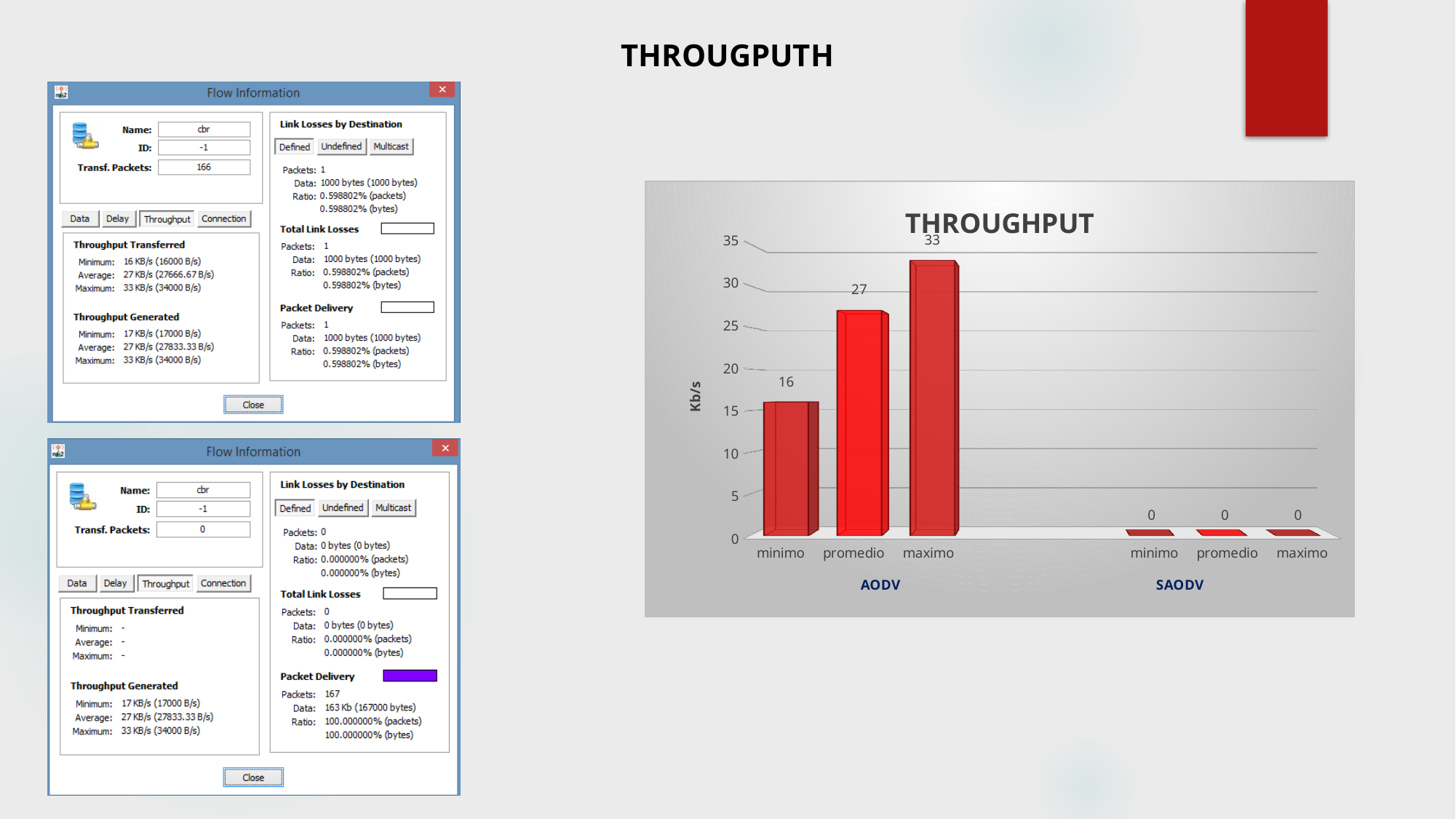
Is the value for AODV promedio greater or less than 25 in the THROUGHPUT chart? greater What is the value for AODV promedio in the THROUGHPUT chart? 27 Which bar is the highest in the THROUGHPUT chart? AODV maximo What is the value for AODV maximo in the THROUGHPUT chart? 33 What kind of chart is the THROUGHPUT chart? bar chart What is the difference between AODV promedio and AODV minimo in the THROUGHPUT chart? 11 How many bars are plotted in the THROUGHPUT chart? 6 What is the value for AODV minimo in the THROUGHPUT chart? 16 Which is larger in the THROUGHPUT chart, AODV promedio or SAODV promedio? AODV promedio What is the label of the vertical axis in the THROUGHPUT chart? Kb/s What is the difference between AODV maximo and AODV minimo in the THROUGHPUT chart? 17 What is the value for SAODV promedio in the THROUGHPUT chart? 0